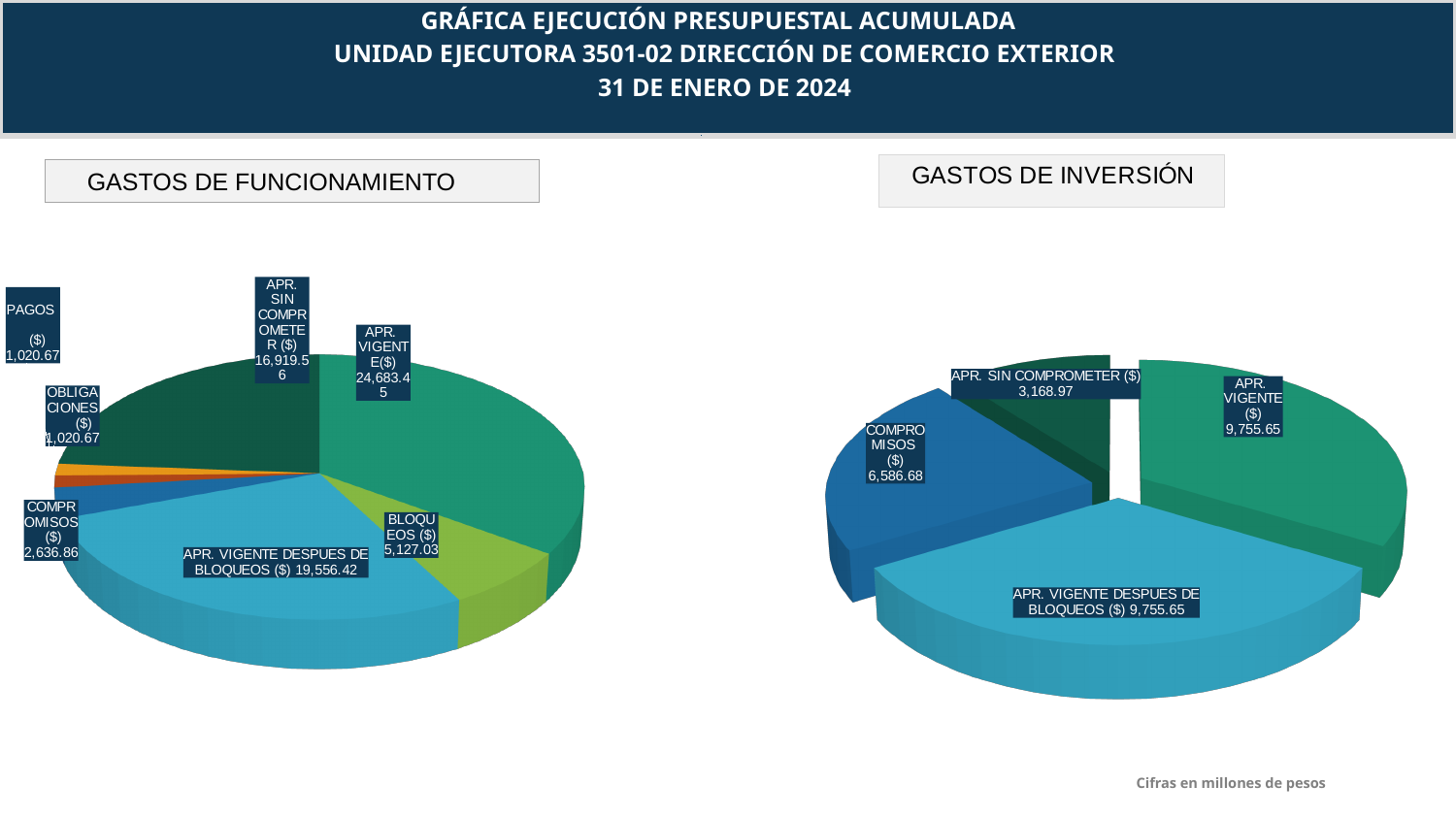
In the GASTOS DE FUNCIONAMIENTO chart, what is the value for APR. VIGENTE DESPUES DE BLOQUEOS ($)? 19,556.42 In the GASTOS DE INVERSIÓN chart, which category has the lowest value? APR. SIN COMPROMETER ($) How many categories are shown in the GASTOS DE INVERSIÓN chart? 4 In the GASTOS DE FUNCIONAMIENTO chart, what is the difference between BLOQUEOS ($) and COMPROMISOS ($)? 2,490.17 In the GASTOS DE INVERSIÓN chart, what is the value for APR. SIN COMPROMETER ($)? 3,168.97 What kind of chart is the GASTOS DE FUNCIONAMIENTO chart? Pie chart In the GASTOS DE FUNCIONAMIENTO chart, which is larger: APR. SIN COMPROMETER ($) or COMPROMISOS ($)? APR. SIN COMPROMETER ($) In the GASTOS DE INVERSIÓN chart, what is the difference between COMPROMISOS ($) and APR. SIN COMPROMETER ($)? 3,417.71 In the GASTOS DE FUNCIONAMIENTO chart, which category has the highest value? APR. VIGENTE ($) In the GASTOS DE INVERSIÓN chart, what is the value for COMPROMISOS ($)? 6,586.68 In the GASTOS DE FUNCIONAMIENTO chart, what is the value for APR. VIGENTE ($)? 24,683.45 In the GASTOS DE FUNCIONAMIENTO chart, what is the value for BLOQUEOS ($)? 5,127.03